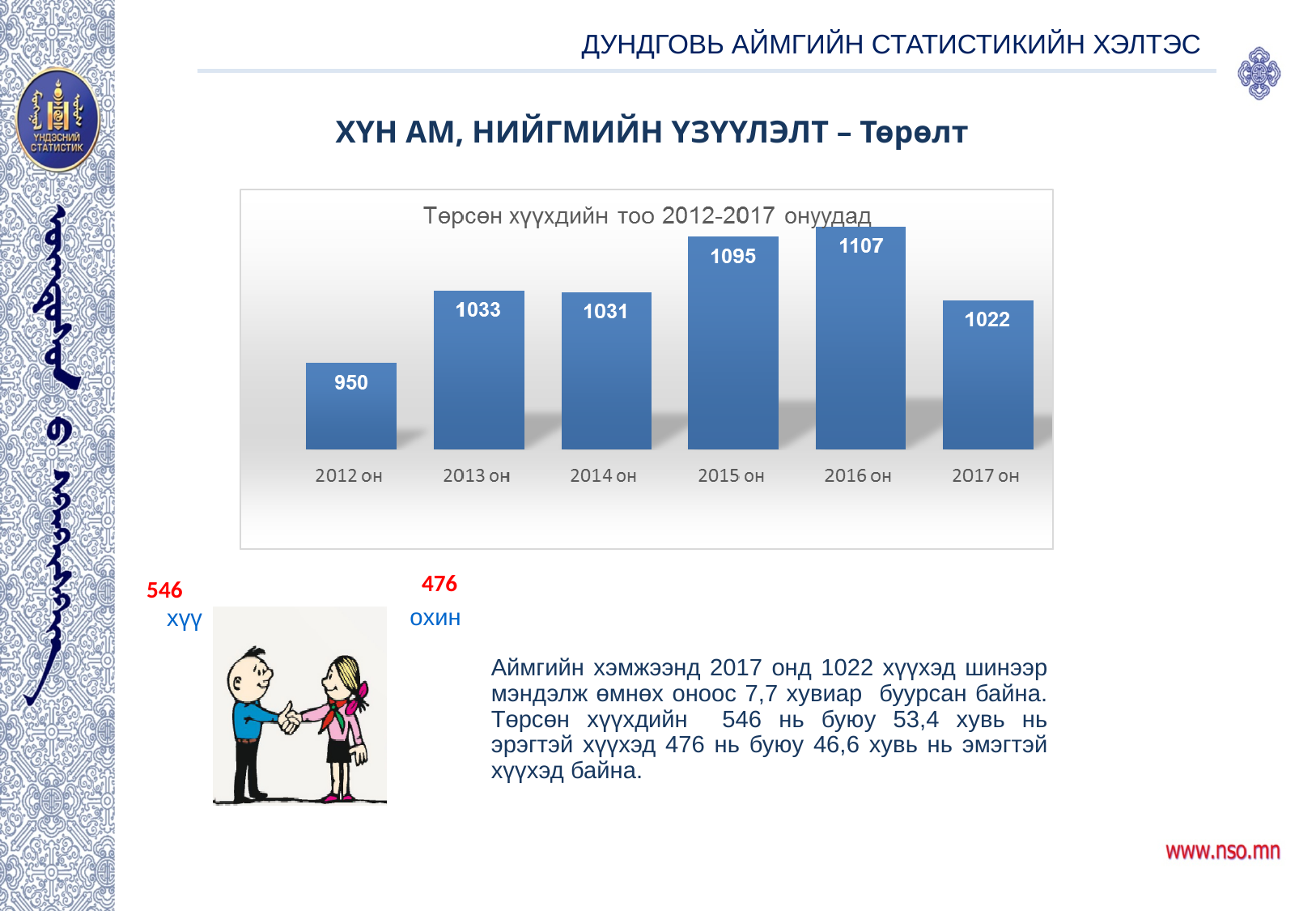
What is the value for 2012 он? 950 Does the value rise or fall from 2016 он to 2017 он? fall What is the value for 2015 он? 1095 How many years are shown in the chart? 6 What is the value for 2017 он? 1022 What kind of chart is shown on the slide? bar chart Which year has the highest value? 2016 он What is the difference between the values for 2016 он and 2017 он? 85 Which is larger, the value for 2015 он or the value for 2014 он? 2015 он Which year has the lowest value? 2012 он What is the title of the chart? Төрсөн хүүхдийн тоо 2012-2017 онуудад What is the difference between the values for 2013 он and 2012 он? 83